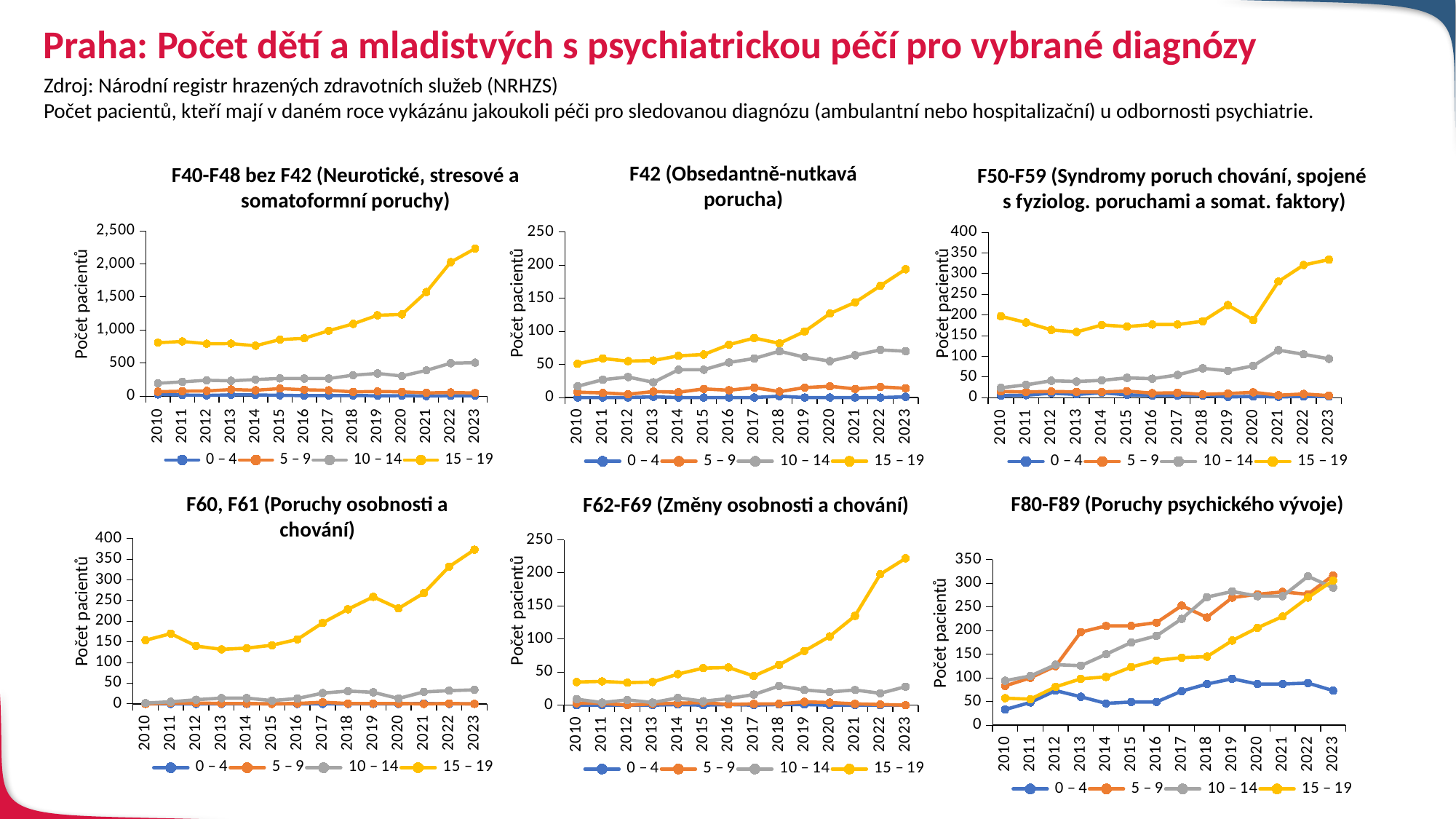
What is the y-axis label on the F50-F59 chart? Počet pacientů In the F80-F89 chart, which is larger in 2013: the 5 – 9 series or the 10 – 14 series? 5 – 9 In the F50-F59 chart, is the 2023 value for the 15 – 19 series greater or less than 300? greater How many series does the legend of the F40-F48 bez F42 chart list? 4 In the F40-F48 bez F42 chart, is the 2023 value for the 15 – 19 series greater or less than 2,000? greater In the F40-F48 bez F42 chart, is the 2010 value for the 15 – 19 series greater or less than 1,000? less What kind of chart is the F42 (Obsedantně-nutkavá porucha) chart? line chart In the F62-F69 (Změny osobnosti a chování) chart, does the 15 – 19 series overall rise or fall from 2010 to 2023? rise How many years are plotted on the x axis of the F60, F61 (Poruchy osobnosti a chování) chart? 14 In the F80-F89 (Poruchy psychického vývoje) chart, which series has the lowest value in 2023? 0 – 4